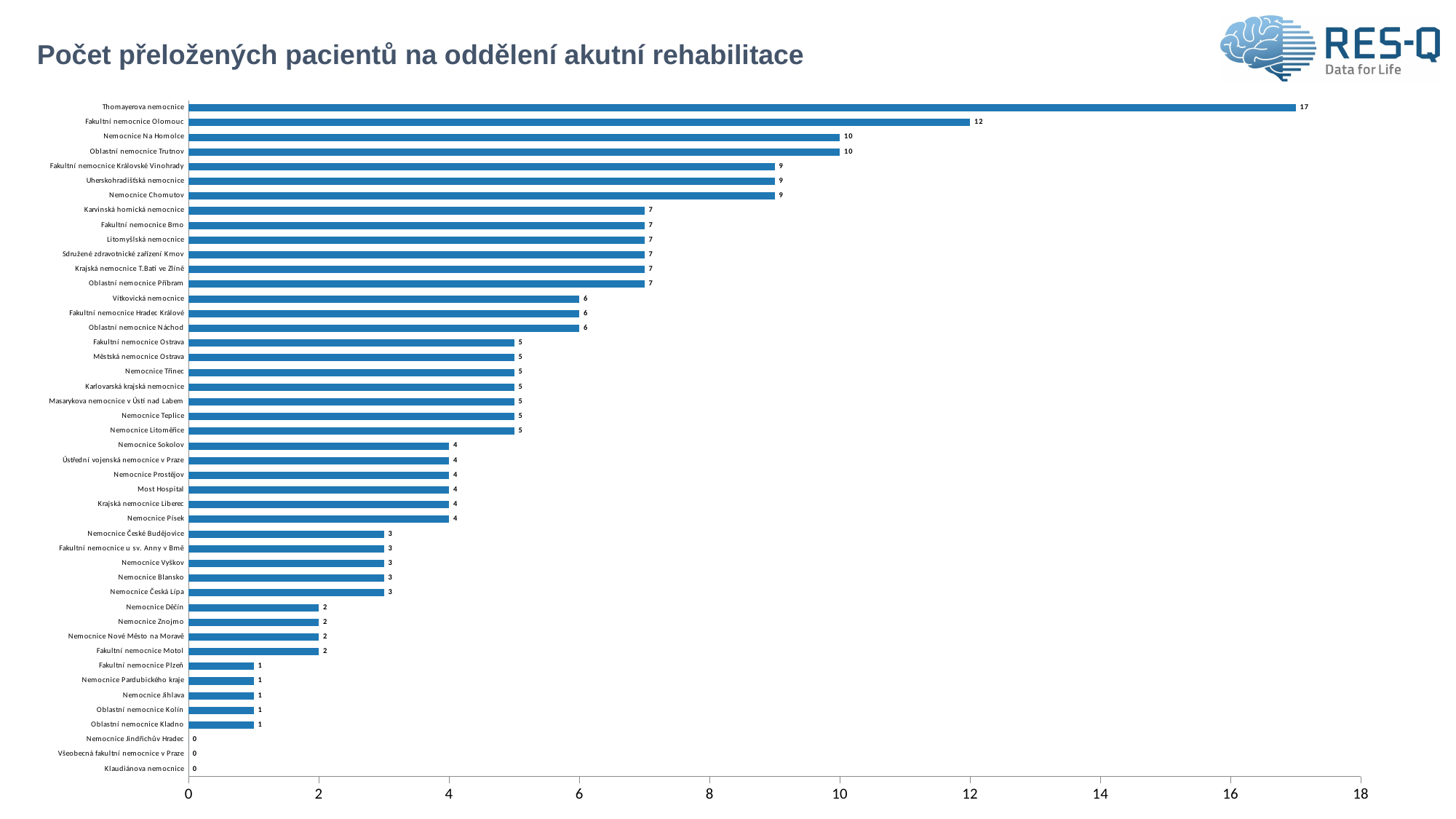
What is the difference between the values for Thomayerova nemocnice and Fakultní nemocnice Olomouc? 5 What is the value for Thomayerova nemocnice? 17 What is the title of the chart? Počet přeložených pacientů na oddělení akutní rehabilitace What is the value for Fakultní nemocnice Olomouc? 12 How many hospitals are listed on the chart? 46 Is the value for Nemocnice Na Homolce greater or less than 8? greater Which is larger, the value for Fakultní nemocnice Brno or the value for Nemocnice Třinec? Fakultní nemocnice Brno What is the difference between the values for Oblastní nemocnice Trutnov and Nemocnice Sokolov? 6 What is the value for Fakultní nemocnice Motol? 2 What is the value for Nemocnice Chomutov? 9 What type of chart is shown on the slide? bar chart Which hospital has the highest value? Thomayerova nemocnice